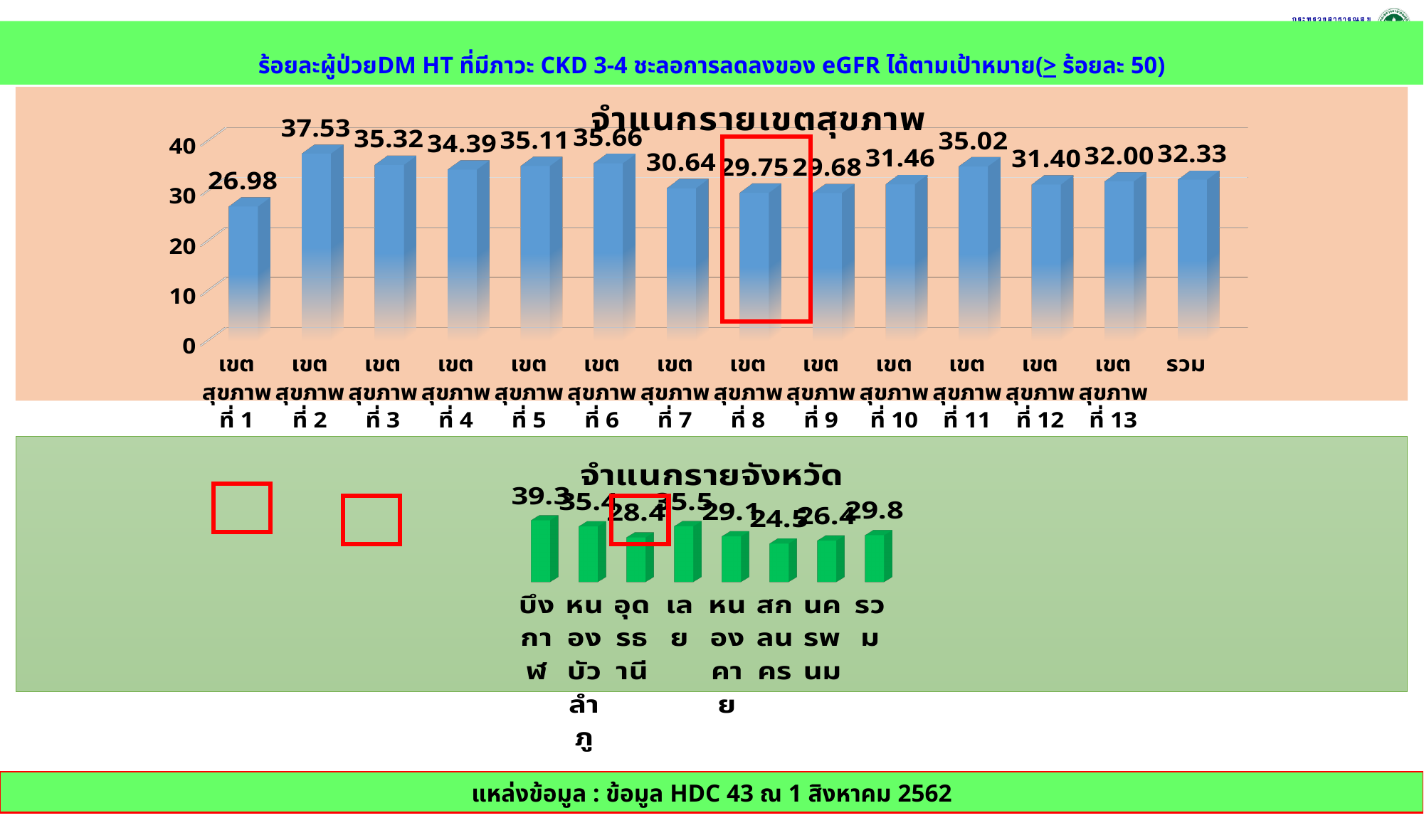
In the top chart (จำแนกรายเขตสุขภาพ), which category has the lowest value? เขตสุขภาพที่ 1 In the top chart (จำแนกรายเขตสุขภาพ), is the value for เขตสุขภาพที่ 1 greater or less than 30? less In the top chart (จำแนกรายเขตสุขภาพ), what is the difference between the values for เขตสุขภาพที่ 2 and เขตสุขภาพที่ 1? 10.55 In the top chart (จำแนกรายเขตสุขภาพ), which category has the highest value? เขตสุขภาพที่ 2 In the bottom chart (จำแนกรายจังหวัด), which province has the highest value? บึงกาฬ What kind of chart is the bottom chart (จำแนกรายจังหวัด)? bar chart In the top chart (จำแนกรายเขตสุขภาพ), which is larger: the value for เขตสุขภาพที่ 6 or เขตสุขภาพที่ 7? เขตสุขภาพที่ 6 How many bars are plotted in the top chart (จำแนกรายเขตสุขภาพ)? 14 In the bottom chart (จำแนกรายจังหวัด), what is the value for อุดรธานี? 28.4 In the top chart (จำแนกรายเขตสุขภาพ), which bar is outlined with a red box? เขตสุขภาพที่ 8 In the top chart (จำแนกรายเขตสุขภาพ), what is the value for เขตสุขภาพที่ 2? 37.53 In the top chart (จำแนกรายเขตสุขภาพ), what is the value for รวม? 32.33